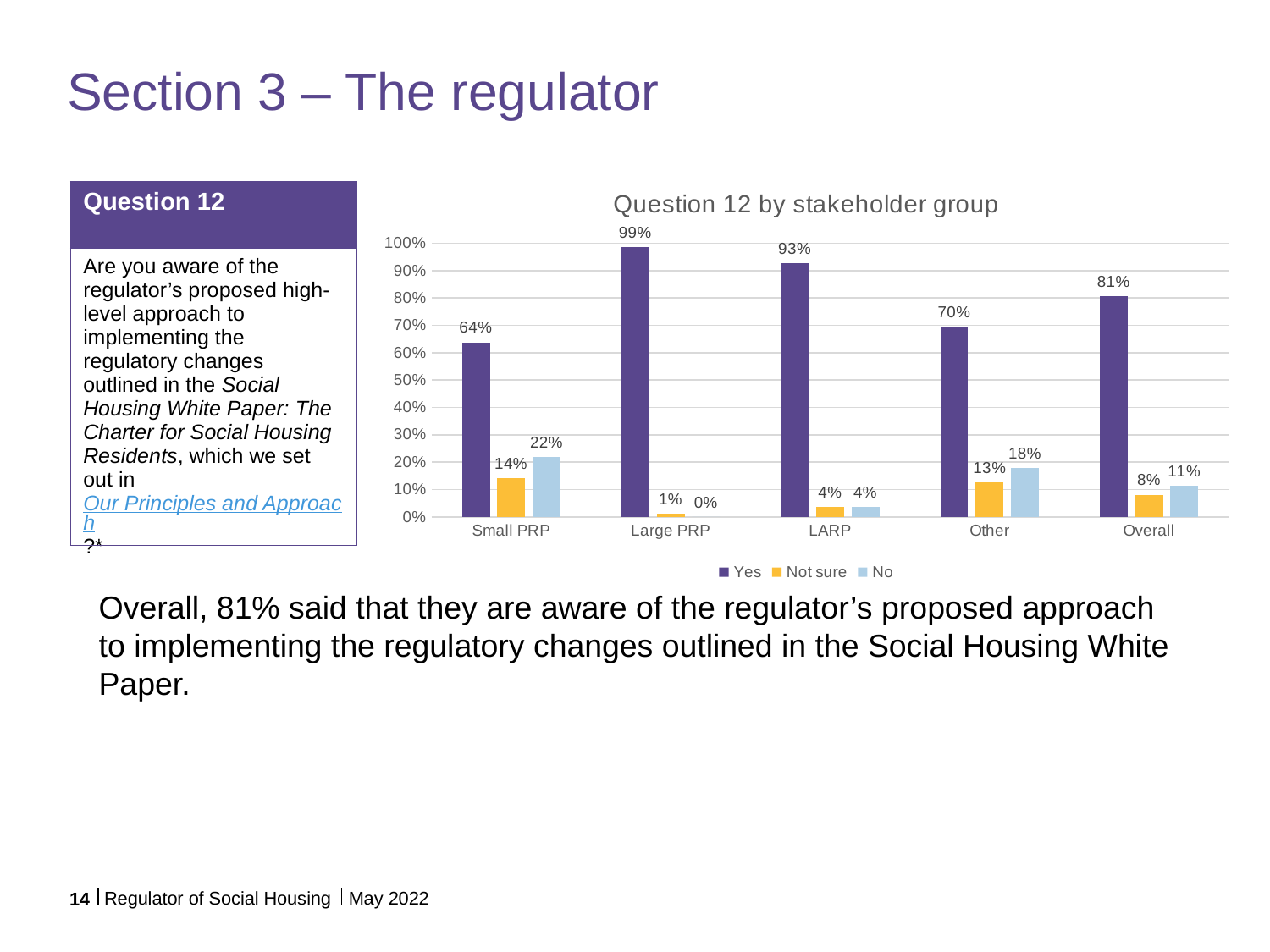
What is the 'Not sure' value for Other? 13% Which is larger, the 'No' value for Small PRP or the 'No' value for Other? Small PRP What is the difference between the 'Yes' values for Large PRP and LARP? 6% What is the title of the chart? Question 12 by stakeholder group How many series does the legend list? 3 How many stakeholder groups are shown on the x axis? 5 Which stakeholder group has the highest 'Yes' value? Large PRP Which stakeholder group has the lowest 'Yes' value? Small PRP Is the 'Yes' value for Other greater or less than 60%? greater What is the 'Yes' value for Small PRP? 64% What kind of chart is shown? Bar chart What is the 'No' value for Large PRP? 0%